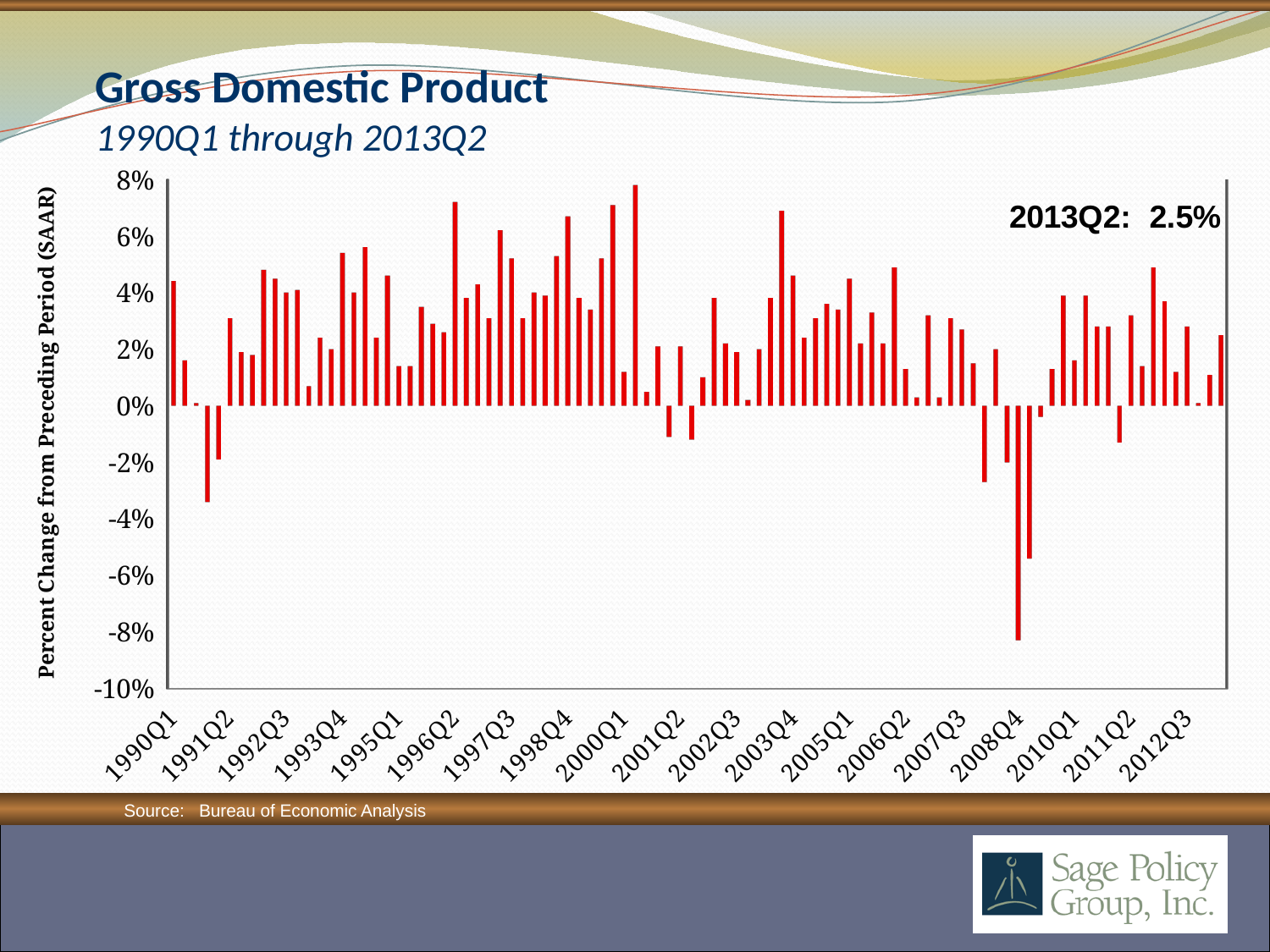
What kind of chart is shown on the slide? bar chart Is the value for 2013Q2 greater or less than 4%? less How many quarter labels are shown along the x axis? 19 Is the value for 1990Q1 greater or less than 2%? greater What is the value shown for 2013Q2? 2.5% What is the title of the y axis? Percent Change from Preceding Period (SAAR) Which labeled quarter has the lowest value on the chart? 2008Q4 Which is larger, the value for 2013Q2 or the value for 2008Q4? 2013Q2 What source is cited for the chart data? Bureau of Economic Analysis Is the value for 2008Q4 greater or less than -6%? less